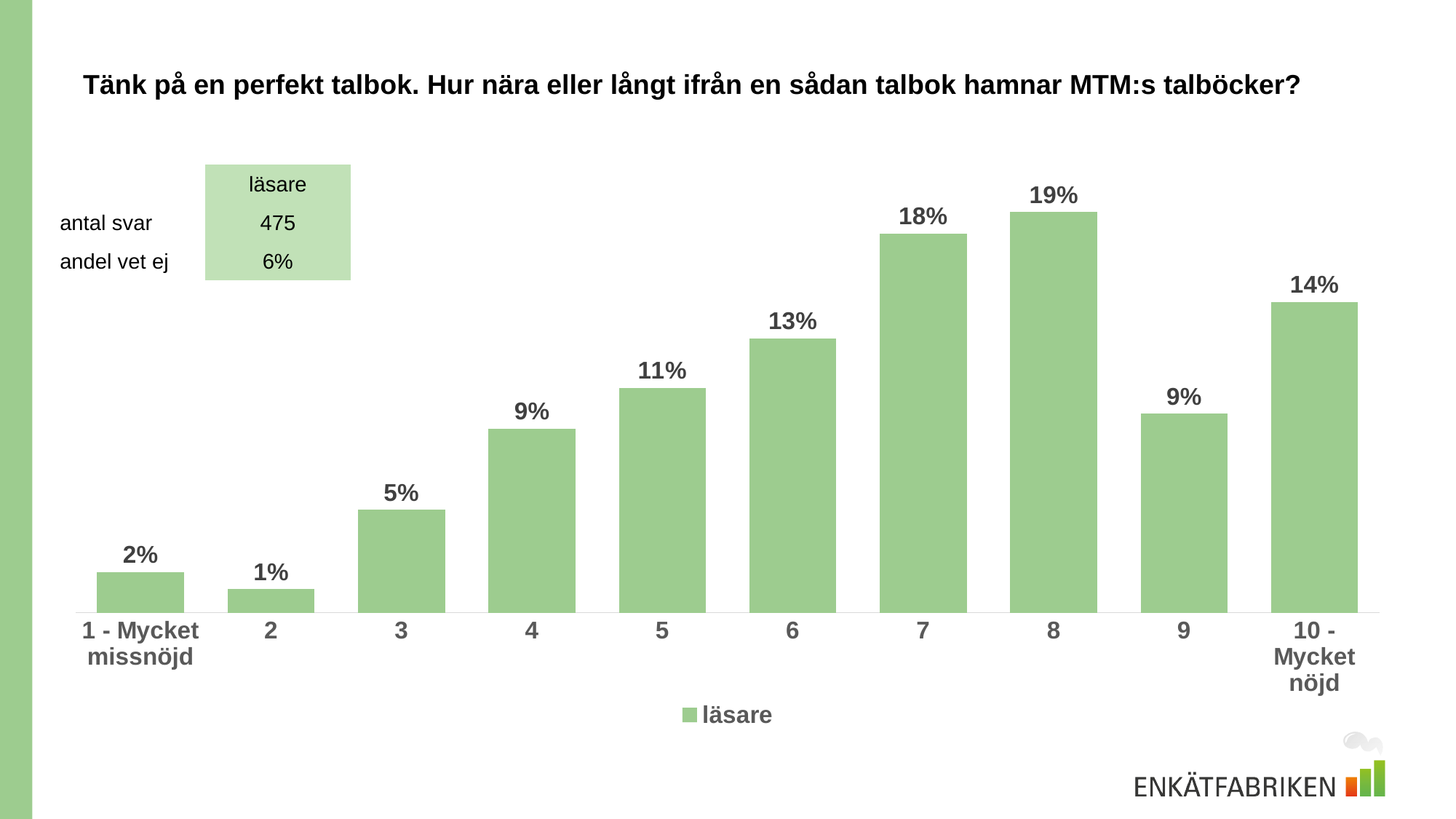
How many categories are shown on the x axis? 10 Which is larger, the value for category 6 or the value for category '10 - Mycket nöjd'? 10 - Mycket nöjd What is the difference between the values for category 8 and category 9? 10% What is the name of the series shown in the legend? läsare How many series does the legend list? 1 Which category has the lowest value? 2 What is the value for category '10 - Mycket nöjd'? 14% What is the value for category 8? 19% What is the value for category '1 - Mycket missnöjd'? 2% What kind of chart is shown on the slide? Bar chart Do the values rise or fall from category 2 to category 8? Rise Which category has the highest value? 8